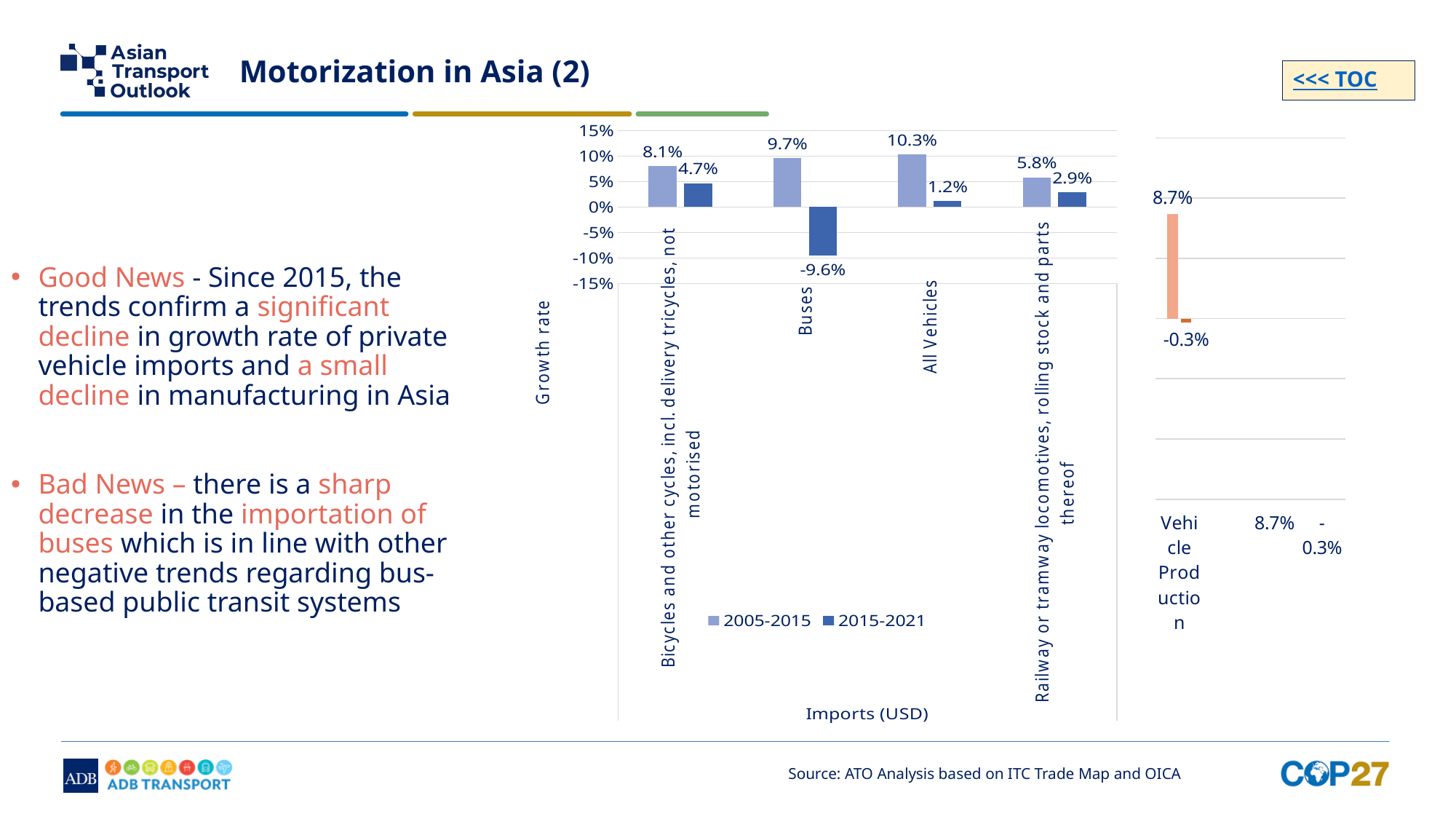
How many categories are shown in the Imports (USD) chart? 4 In the Vehicle Production chart on the right, what are the two values shown? 8.7% and -0.3% In the Imports (USD) chart, which is larger: the 2015-2021 growth rate for Bicycles and other cycles or for Railway or tramway locomotives, rolling stock and parts thereof? Bicycles and other cycles In the Imports (USD) chart, what is the 2015-2021 growth rate for All Vehicles? 1.2% What type of chart is the Imports (USD) chart? Bar chart In the Imports (USD) chart, what is the 2015-2021 growth rate for Buses? -9.6% In the Imports (USD) chart, which category has the lowest 2015-2021 growth rate? Buses How many series does the legend of the Imports (USD) chart list? 2 In the Imports (USD) chart, what is the difference between the 2005-2015 and 2015-2021 growth rates for Bicycles and other cycles, incl. delivery tricycles, not motorised? 3.4% In the Imports (USD) chart, what is the 2005-2015 growth rate for Railway or tramway locomotives, rolling stock and parts thereof? 5.8% In the Imports (USD) chart, what is the 2005-2015 growth rate for Buses? 9.7% In the Imports (USD) chart, which category has the highest 2005-2015 growth rate? All Vehicles